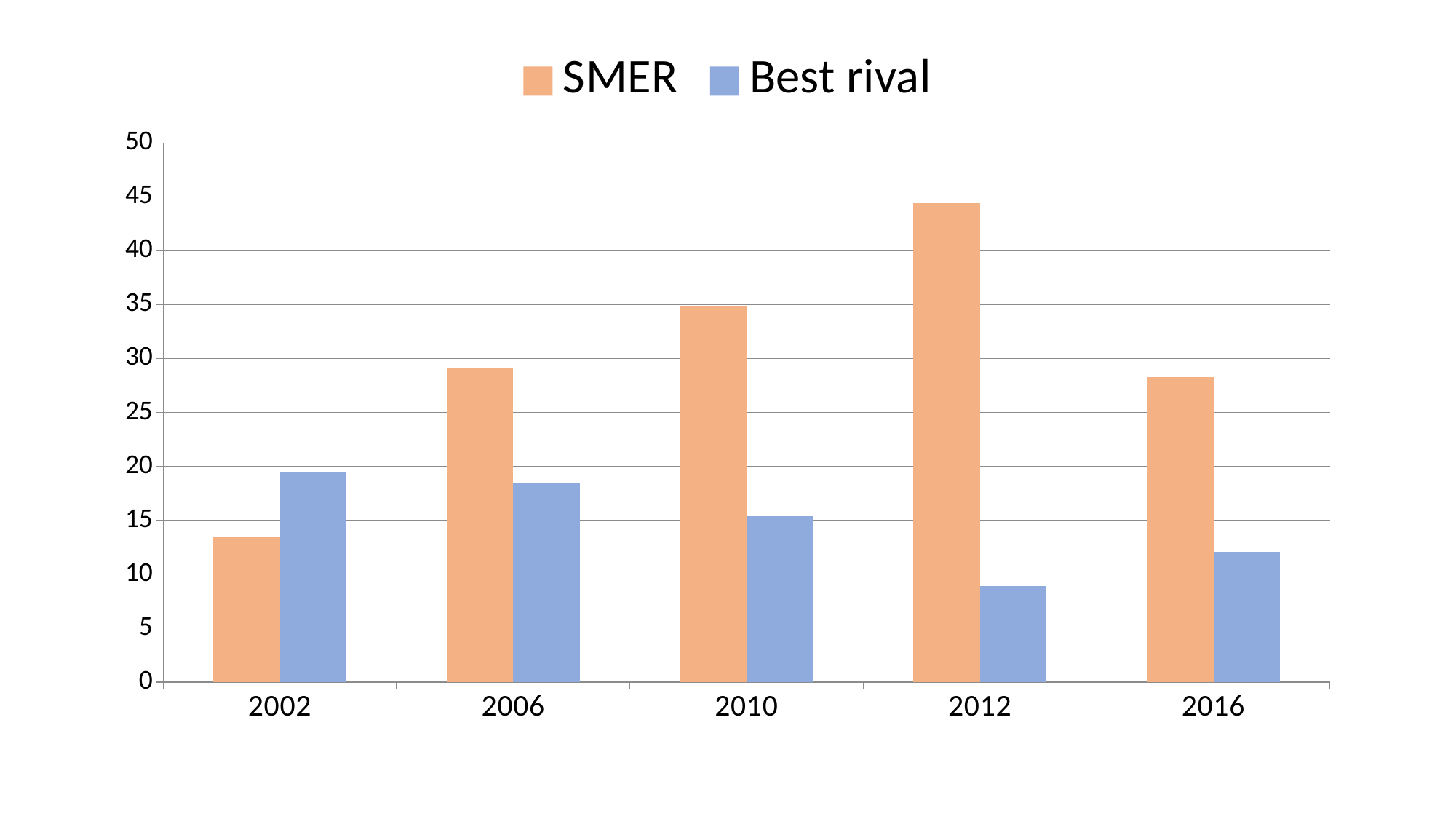
Does the Best rival value rise or fall from 2002 to 2012? fall Is the Best rival value for 2012 greater or less than 10? less In which year is the SMER value lowest? 2002 How many years are shown on the x axis? 5 In 2012, which is larger: SMER or Best rival? SMER How many series does the legend list? 2 Is the SMER value for 2012 greater or less than 40? greater In 2002, which is larger: SMER or Best rival? Best rival What kind of chart is shown on the slide? bar chart Is the SMER value for 2002 greater or less than 15? less In which year is the SMER value highest? 2012 In which year is the Best rival value lowest? 2012